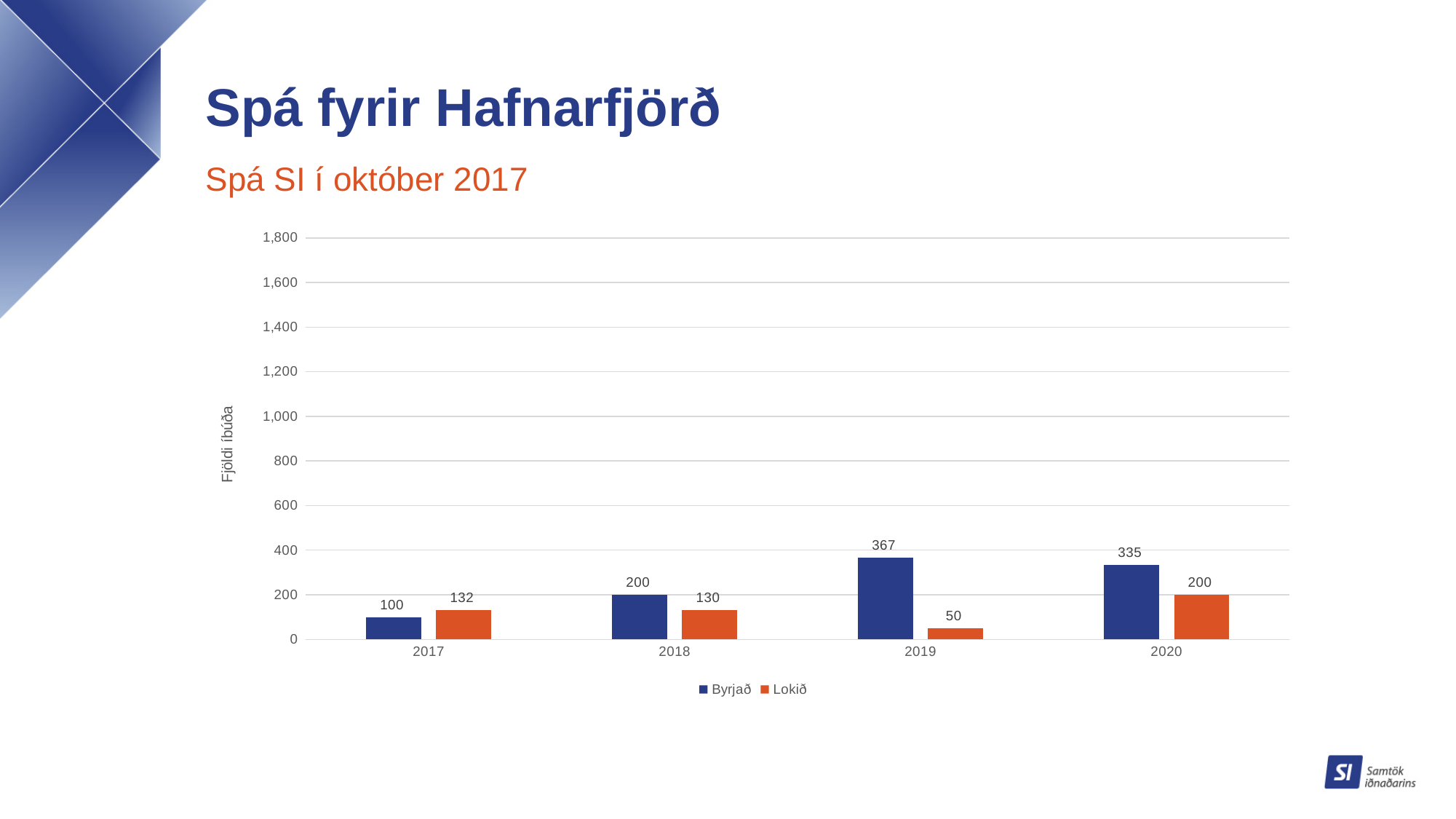
What is the label of the y axis? Fjöldi íbúða Which is larger in 2017, Byrjað or Lokið? Lokið What is the value for Lokið in 2017? 132 What is the value for Byrjað in 2019? 367 What is the value for Lokið in 2020? 200 Which year has the lowest value for Lokið? 2019 What kind of chart is shown on the slide? Bar chart Which year has the highest value for Byrjað? 2019 How many series does the legend list? 2 How many years are shown on the x axis? 4 What is the difference between Byrjað and Lokið in 2019? 317 What is the difference between Byrjað in 2020 and Byrjað in 2018? 135